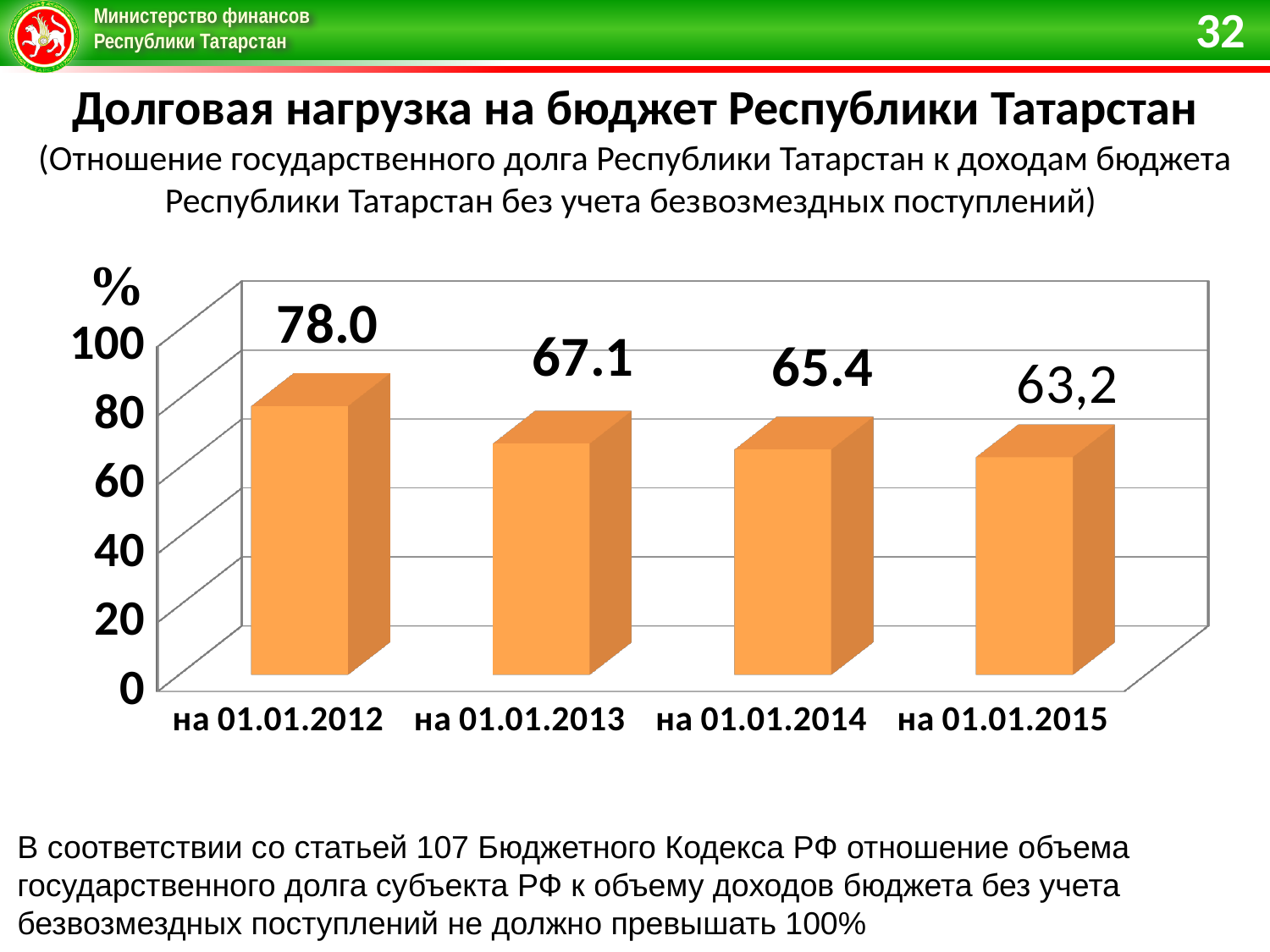
Is the value for на 01.01.2012 greater or less than 80? less What kind of chart is shown on the slide? bar chart Do the values rise or fall from на 01.01.2012 to на 01.01.2015? fall How many dates are shown on the x axis? 4 What is the value for на 01.01.2015? 63,2 Which date has the highest value? на 01.01.2012 Which is larger, the value for на 01.01.2013 or на 01.01.2014? на 01.01.2013 What is the value for на 01.01.2012? 78.0 What is the value for на 01.01.2014? 65.4 What is the difference between the values for на 01.01.2012 and на 01.01.2013? 10.9 What is the value for на 01.01.2013? 67.1 Which date has the lowest value? на 01.01.2015